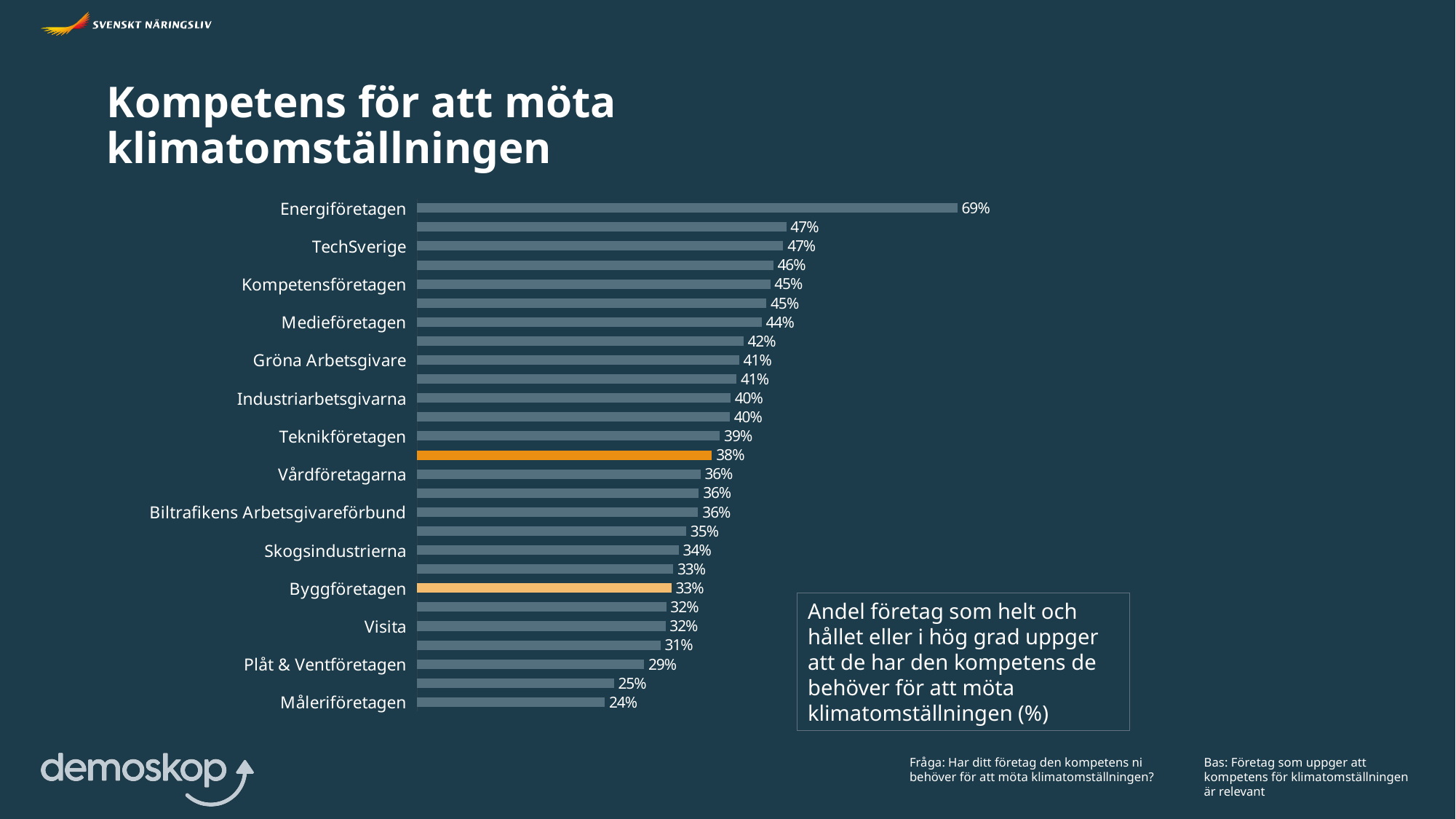
What kind of chart is shown on the slide? Bar chart What is the value for Energiföretagen? 69% Which is larger, the value for Kompetensföretagen or the value for Visita? Kompetensföretagen Which category has the highest value? Energiföretagen What is the value for Byggföretagen? 33% What is the value for Måleriföretagen? 24% Which category has the lowest value? Måleriföretagen What is the difference between the values for TechSverige and Byggföretagen? 14 percentage points What is the value for Gröna Arbetsgivare? 41% What is the difference between the values for Energiföretagen and Måleriföretagen? 45 percentage points Do the values rise or fall going from the top bar to the bottom bar? Fall Which labelled category's bar is highlighted in light orange? Byggföretagen